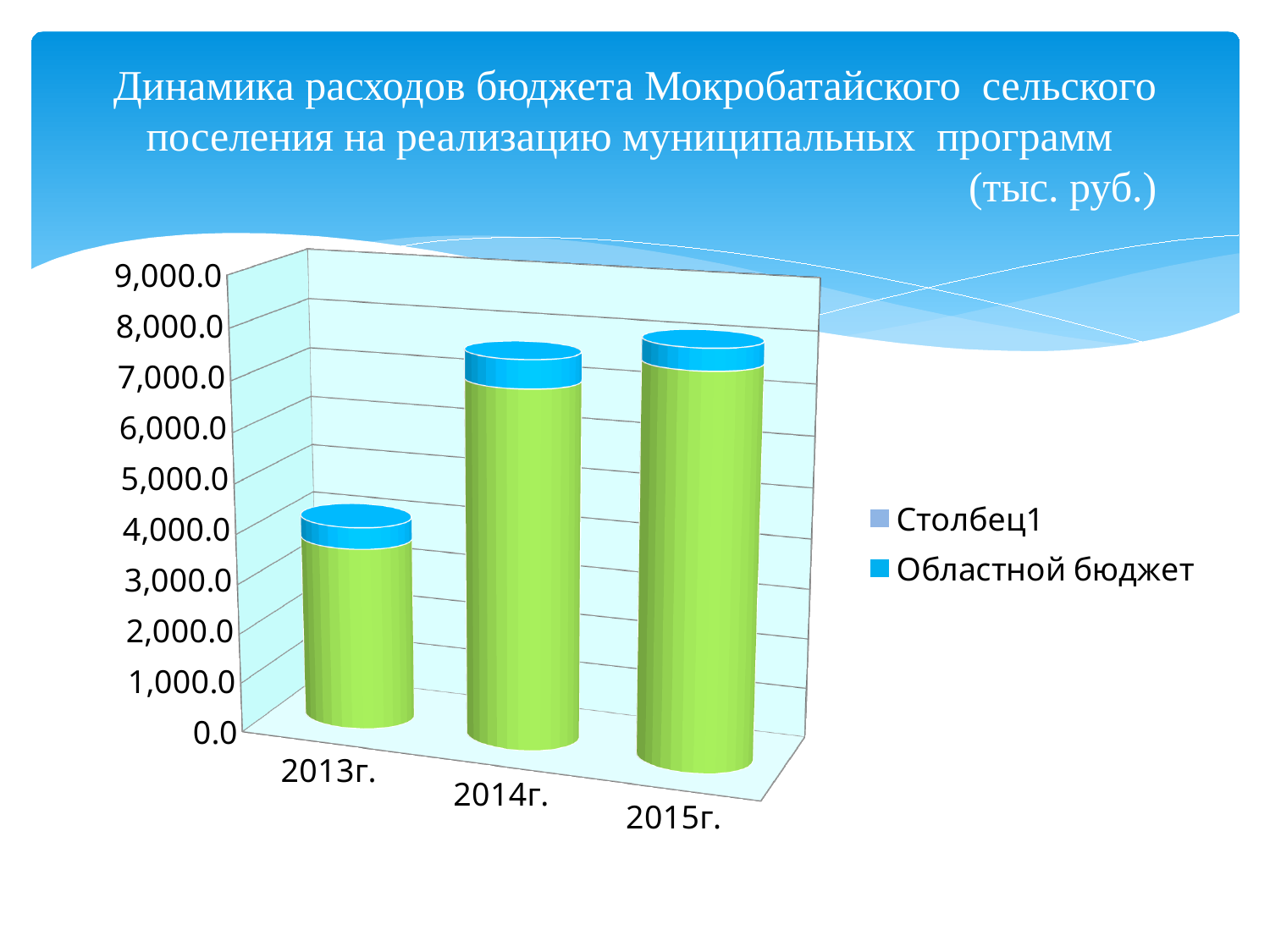
Is the total bar for 2014г. greater or less than 6,000.0? greater Is the total bar for 2015г. greater or less than 9,000.0? less What are the two legend entries of the chart? Столбец1 and Областной бюджет In what units are the values on the chart given, according to the title? тыс. руб. How many series does the legend list? 2 Is the total bar for 2013г. greater or less than 3,000.0? greater Which is larger, the total bar for 2013г. or for 2014г.? 2014г. Which year has the lowest total bar? 2013г. Do the bar totals rise or fall from 2013г. to 2015г.? rise How many years (categories) are shown on the x axis? 3 What kind of chart is shown on the slide? bar chart